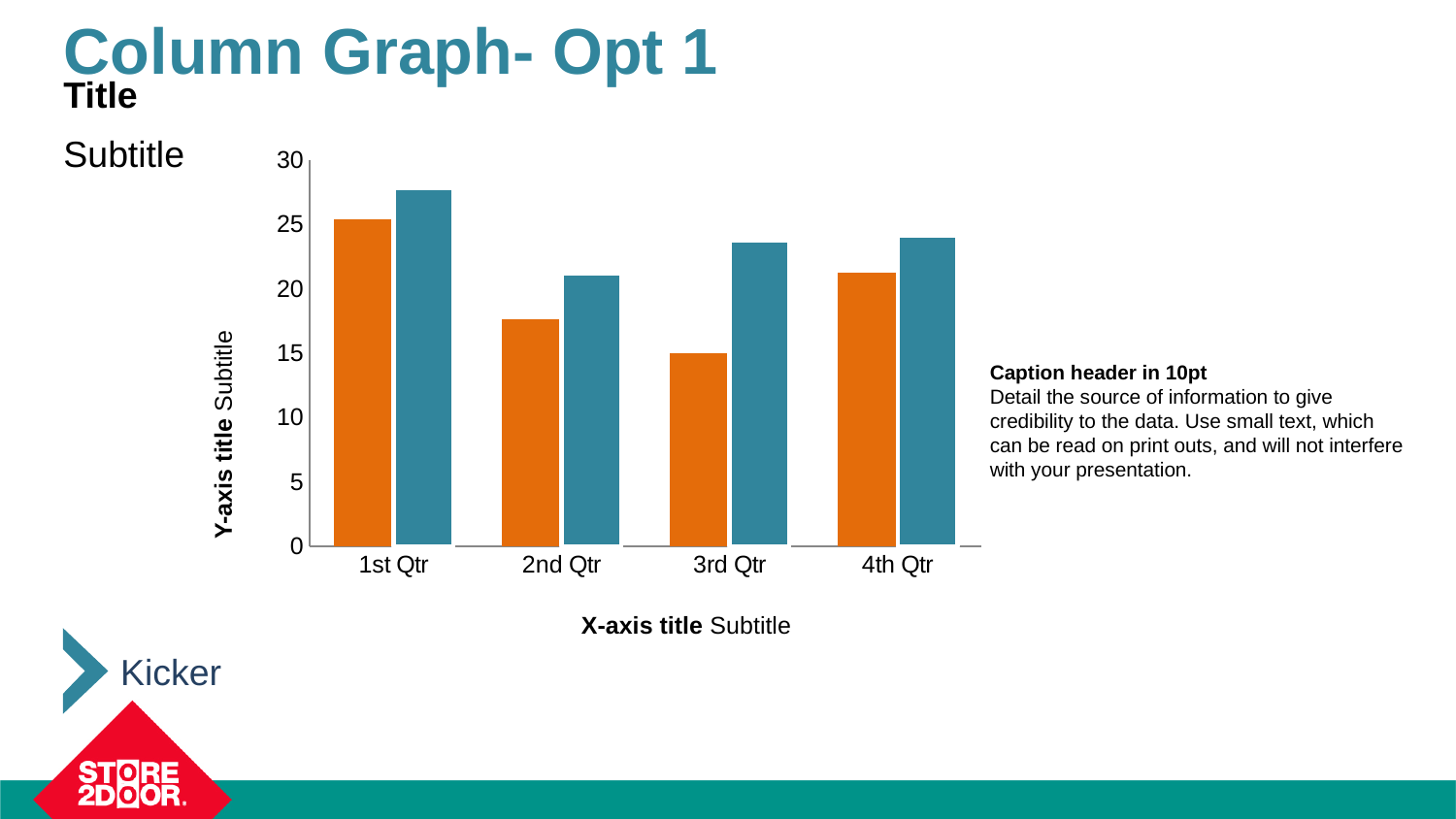
Which category has the tallest teal bar? 1st Qtr In 1st Qtr, which bar is taller, the orange one or the teal one? teal What is the x-axis title of the chart? X-axis title Subtitle How many categories are shown on the x axis of the chart? 4 Is the value of the teal bar for 1st Qtr greater or less than 25? greater In 3rd Qtr, which bar is taller, the orange one or the teal one? teal Which category has the tallest orange bar? 1st Qtr Which category has the shortest teal bar? 2nd Qtr Is the value of the orange bar for 3rd Qtr greater or less than 20? less Do the orange bars rise or fall from 1st Qtr to 3rd Qtr? fall What kind of chart is shown on the slide? bar chart Which category has the shortest orange bar? 3rd Qtr